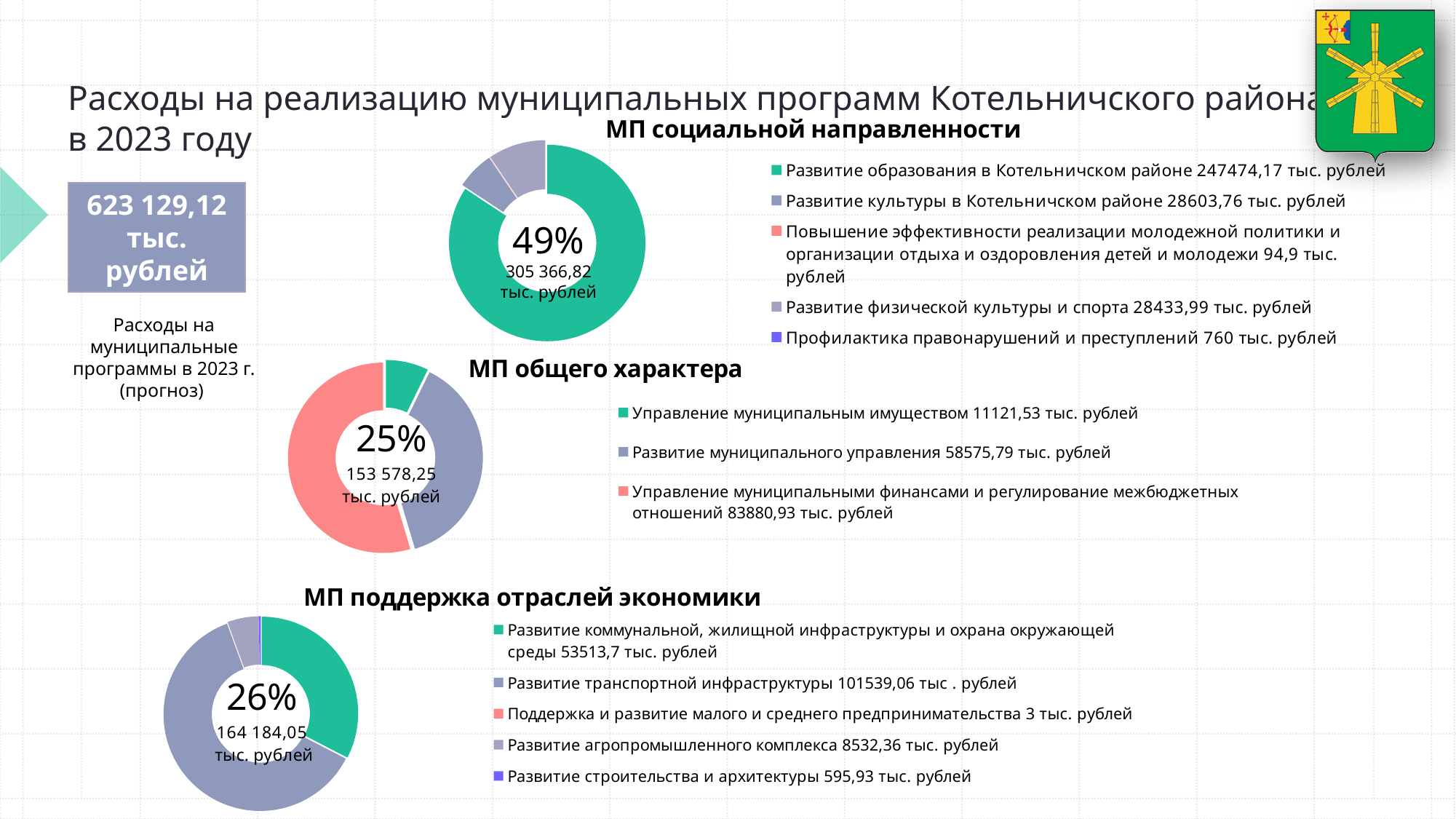
What kind of chart is used for «МП социальной направленности»? Doughnut (pie) chart What total amount is shown in the centre of the «МП поддержка отраслей экономики» chart? 164 184,05 тыс. рублей In the «МП социальной направленности» chart, how many categories does the legend list? 5 In the «МП общего характера» chart, what is the difference between «Управление муниципальными финансами и регулирование межбюджетных отношений» and «Развитие муниципального управления»? 25305,14 тыс. рублей In the «МП общего характера» chart, which category has the highest value? Управление муниципальными финансами и регулирование межбюджетных отношений In the «МП социальной направленности» chart, what is the value for «Развитие культуры в Котельничском районе»? 28603,76 тыс. рублей In the «МП социальной направленности» chart, which category has the lowest value? Повышение эффективности реализации молодежной политики и организации отдыха и оздоровления детей и молодежи In the «МП поддержка отраслей экономики» chart, which is larger: «Развитие транспортной инфраструктуры» or «Развитие коммунальной, жилищной инфраструктуры и охрана окружающей среды»? Развитие транспортной инфраструктуры In the «МП поддержка отраслей экономики» chart, which category has the lowest value? Поддержка и развитие малого и среднего предпринимательства What percentage is shown in the centre of the «МП социальной направленности» chart? 49% In the «МП социальной направленности» chart, which category has the highest value? Развитие образования в Котельничском районе In the «МП общего характера» chart, what is the value for «Развитие муниципального управления»? 58575,79 тыс. рублей